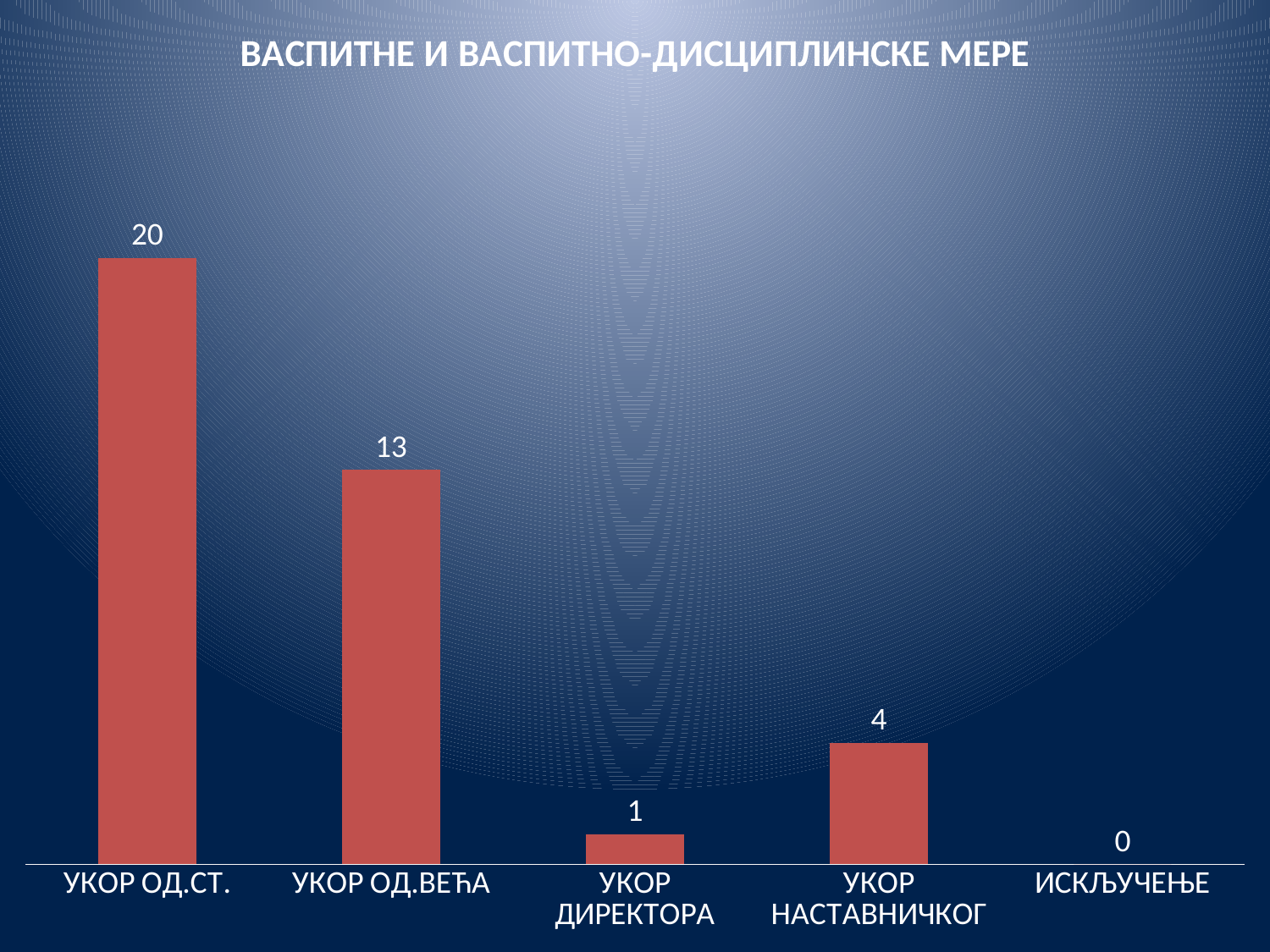
What kind of chart is shown on the slide? Bar chart What is the value for УКОР ОД.ВЕЋА? 13 Which category has the lowest value? ИСКЉУЧЕЊЕ What is the value for УКОР НАСТАВНИЧКОГ? 4 Which is larger, the value for УКОР НАСТАВНИЧКОГ or the value for УКОР ДИРЕКТОРА? УКОР НАСТАВНИЧКОГ What is the value for УКОР ДИРЕКТОРА? 1 What is the difference between the values for УКОР ОД.СТ. and УКОР ОД.ВЕЋА? 7 What is the title of the chart? ВАСПИТНЕ И ВАСПИТНО-ДИСЦИПЛИНСКЕ МЕРЕ How many categories are shown on the chart? 5 Which category has the highest value? УКОР ОД.СТ. What is the value for ИСКЉУЧЕЊЕ? 0 What is the value for УКОР ОД.СТ.? 20